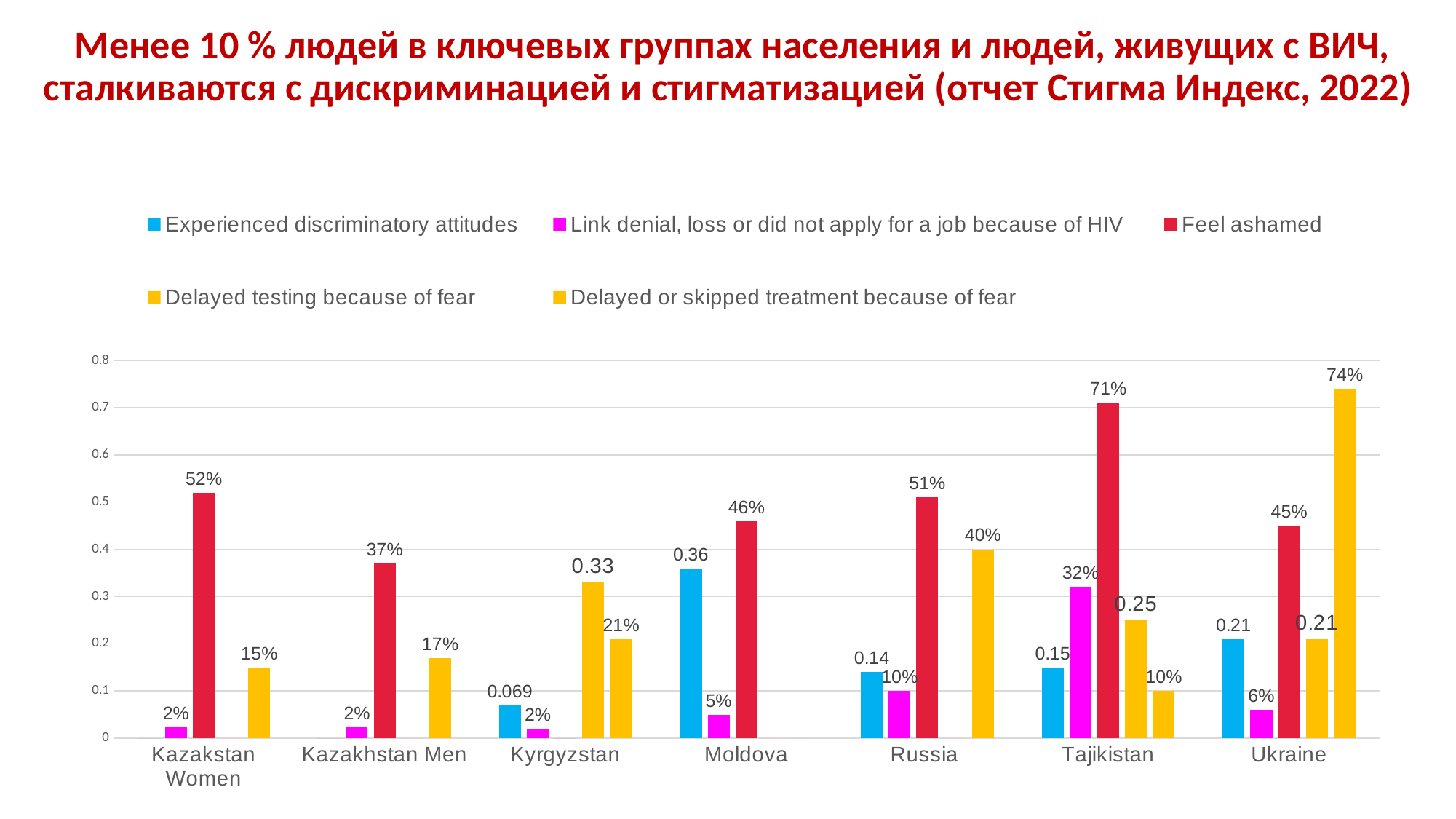
What kind of chart is shown on the slide? bar chart What is the 'Feel ashamed' value for Tajikistan? 71% What is the difference between the 'Feel ashamed' values for Kazakstan Women and Kazakhstan Men? 15% Which country has the highest 'Feel ashamed' value? Tajikistan What is the 'Link denial, loss or did not apply for a job because of HIV' value for Tajikistan? 32% How many series does the legend list? 5 What is the 'Experienced discriminatory attitudes' value for Kyrgyzstan? 0.069 Which has the larger 'Feel ashamed' value, Russia or Moldova? Russia Which country has the tallest bar in the chart? Ukraine Is the 'Feel ashamed' value for Ukraine greater or less than 0.4? greater What is the 'Experienced discriminatory attitudes' value for Moldova? 0.36 How many countries/groups are shown on the x axis? 7